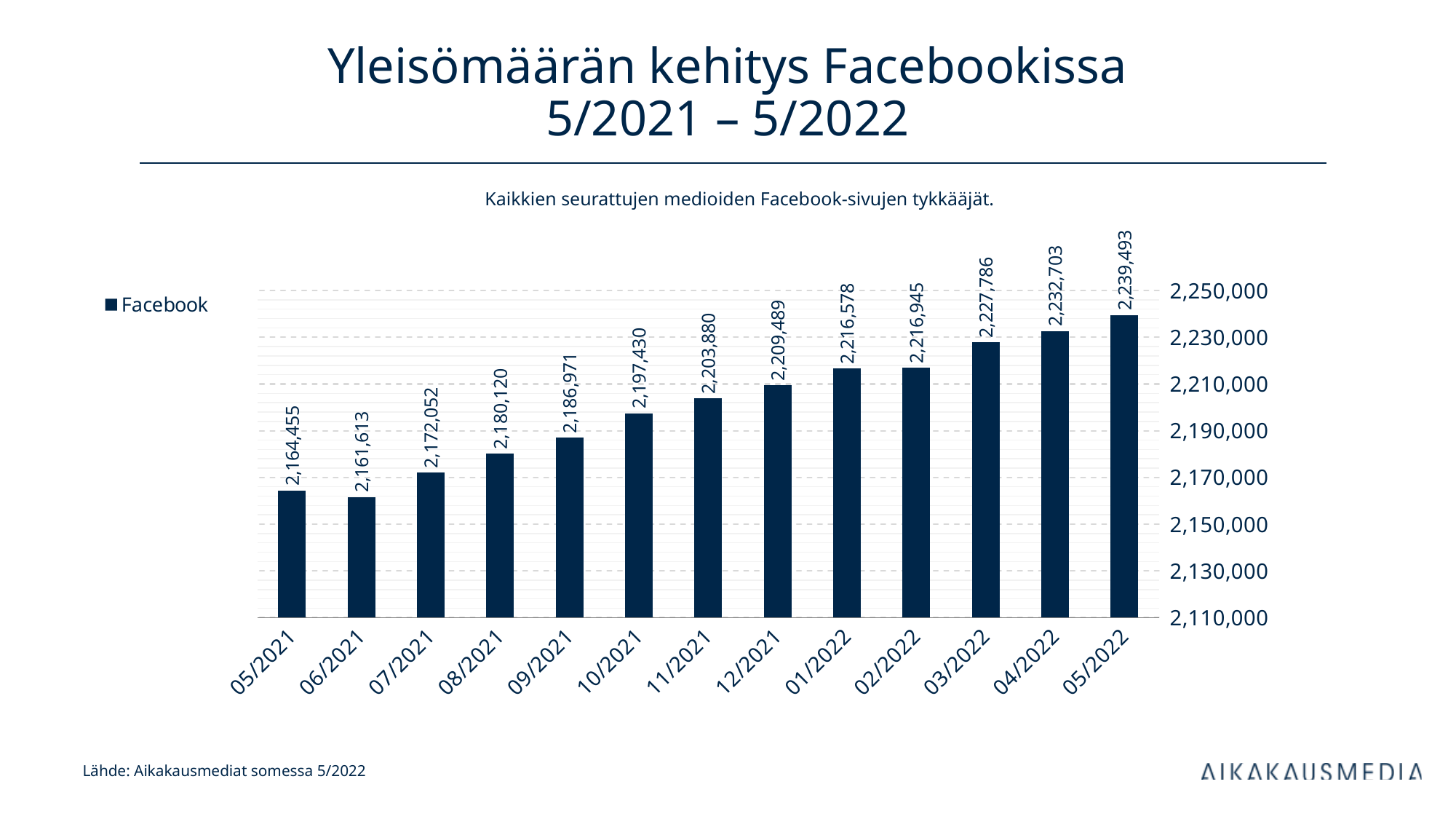
What is the value for 09/2021? 2,186,971 What is the value for 05/2022? 2,239,493 Which month has the highest value? 05/2022 What kind of chart is this? bar chart What is the difference between the values for 05/2022 and 05/2021? 75,038 Which is larger, the value for 03/2022 or the value for 12/2021? 03/2022 What is the difference between the values for 05/2021 and 06/2021? 2,842 Is the value for 10/2021 greater or less than 2,190,000? greater What is the value for 12/2021? 2,209,489 How many months are shown on the x axis? 13 Do the values generally rise or fall from 06/2021 to 05/2022? rise Which month has the lowest value? 06/2021